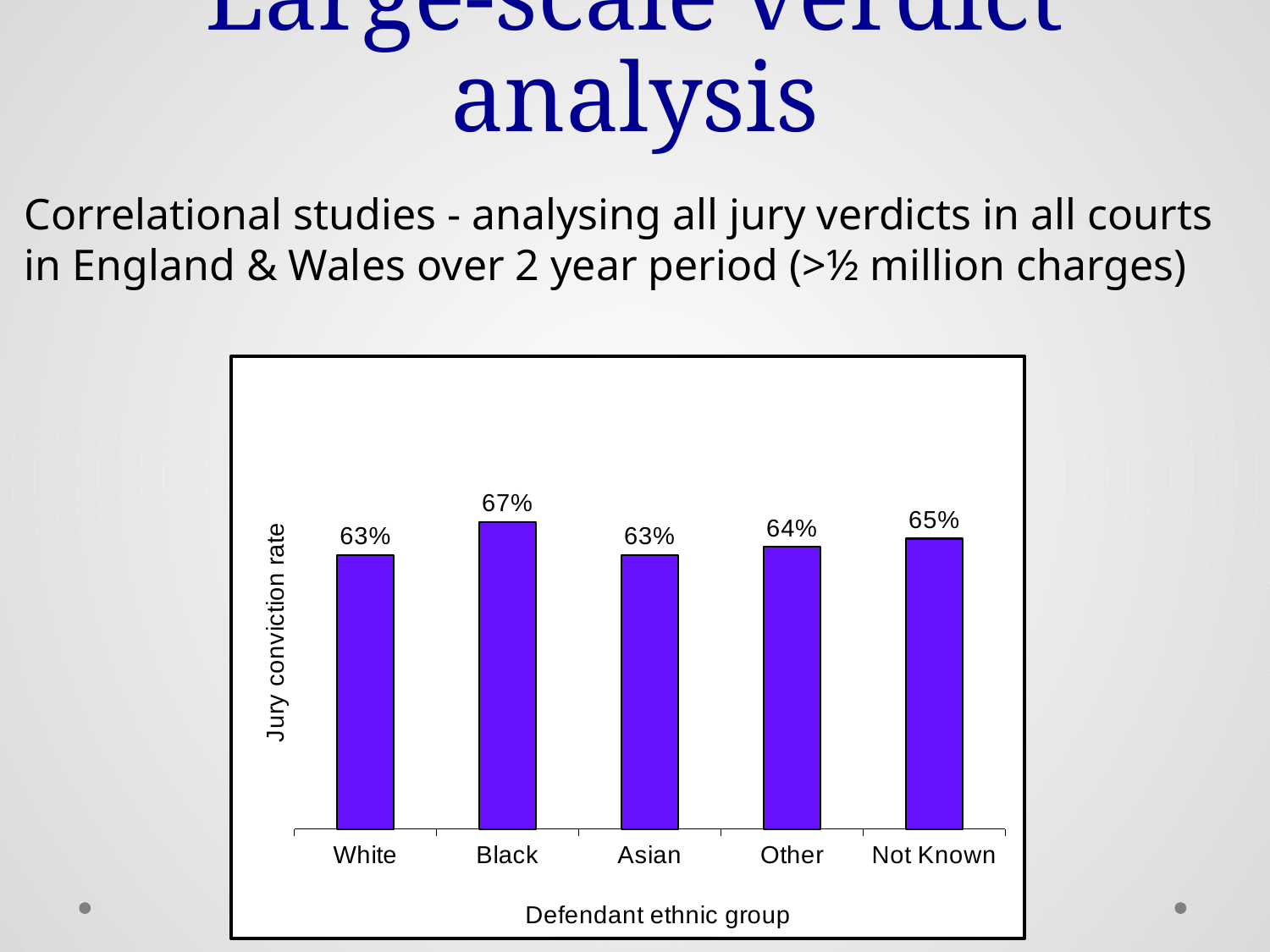
What is the difference in jury conviction rate between Not Known and Asian defendants? 2% How many defendant ethnic groups are shown on the chart? 5 What is the label of the horizontal axis of the chart? Defendant ethnic group What is the jury conviction rate for the Other ethnic group? 64% What is the label of the vertical axis of the chart? Jury conviction rate Which has a higher jury conviction rate, Black or Other? Black What is the jury conviction rate for White defendants? 63% What is the jury conviction rate for the Not Known ethnic group? 65% What kind of chart is shown on the slide? Bar chart Which defendant ethnic group has the highest jury conviction rate? Black What is the jury conviction rate for Black defendants? 67% What is the difference in jury conviction rate between Black and White defendants? 4%